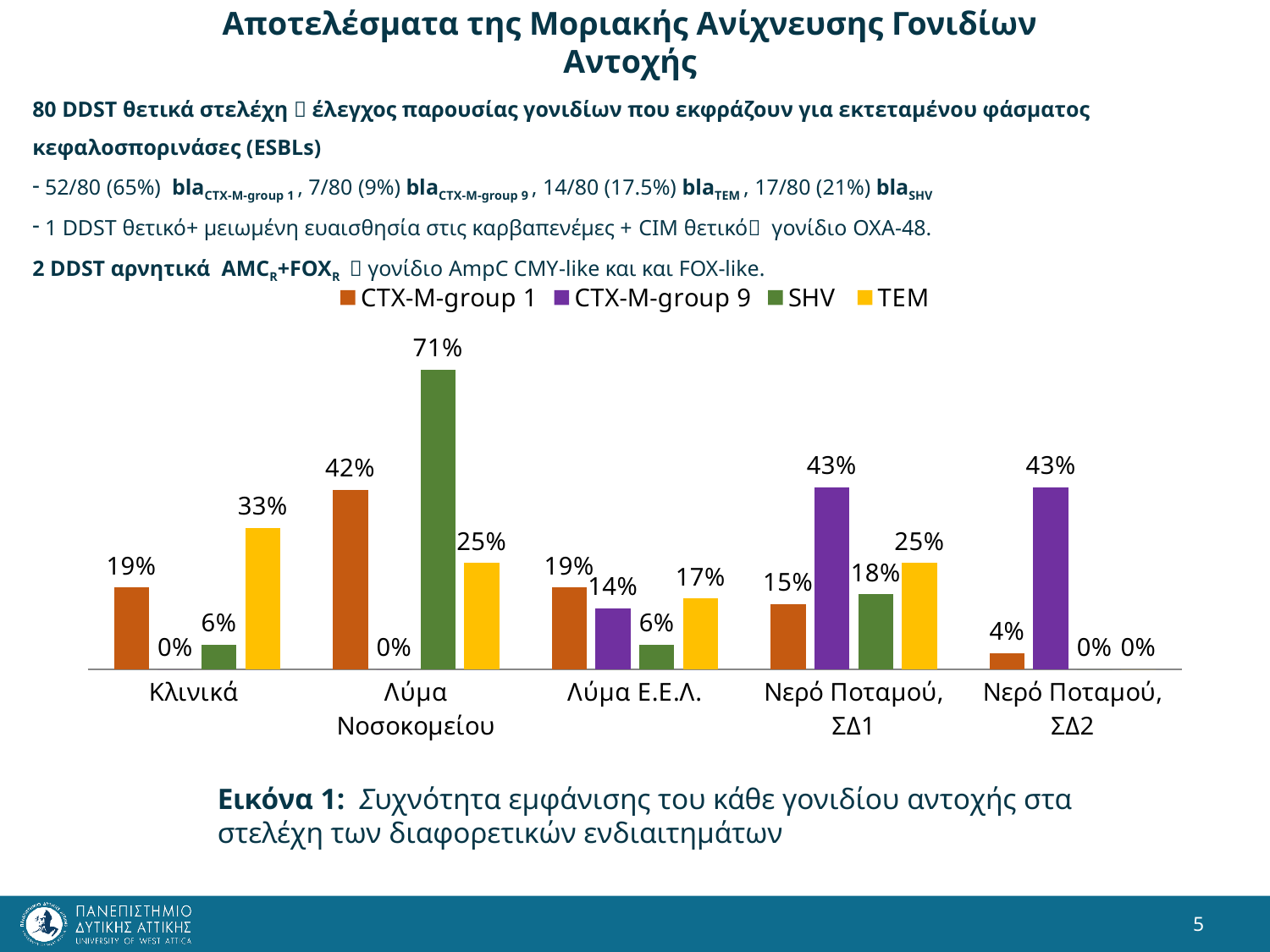
Which series is shown in green in the chart? SHV How many categories are shown on the x axis of the chart? 5 Which series has the highest value in the Λύμα Νοσοκομείου category? SHV How many series does the chart legend list? 4 What is the value for CTX-M-group 9 in the Νερό Ποταμού, ΣΔ2 category? 43% What is the value for CTX-M-group 1 in the Νερό Ποταμού, ΣΔ2 category? 4% What kind of chart is shown on the slide? bar chart Which series has the lowest value in the Λύμα Ε.Ε.Λ. category? SHV What is the value for SHV in the Λύμα Νοσοκομείου category? 71% Which is larger: the TEM value for Νερό Ποταμού, ΣΔ1 or the TEM value for Λύμα Ε.Ε.Λ.? Νερό Ποταμού, ΣΔ1 What is the difference between the CTX-M-group 1 value in Λύμα Νοσοκομείου and the CTX-M-group 1 value in Κλινικά? 23% What is the value for TEM in the Κλινικά category? 33%